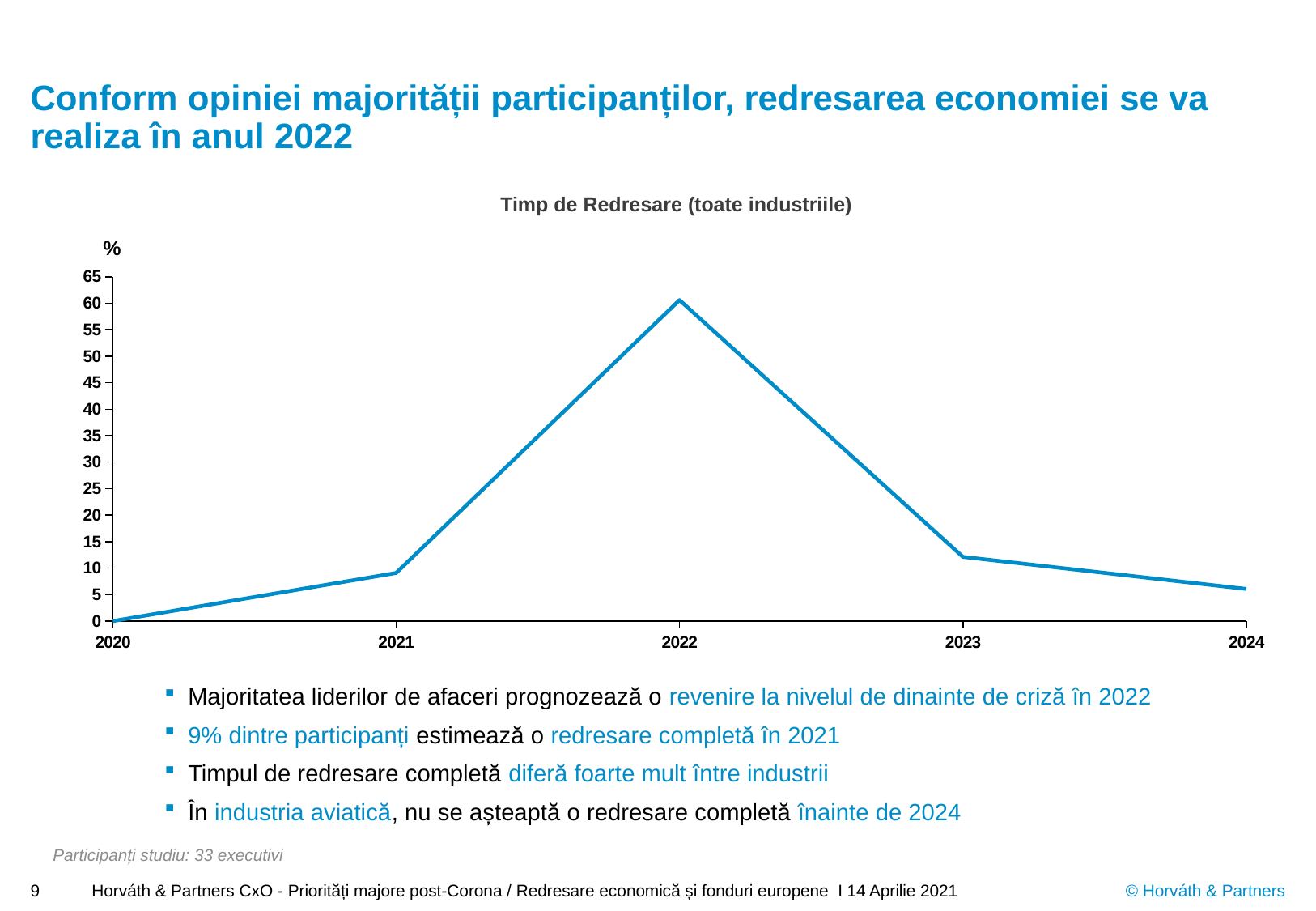
Is the value for 2023 greater or less than 20? less What kind of chart is shown on the slide? line chart Is the value for 2022 greater or less than 50? greater What unit is shown on the y axis of the chart? % Do the values rise or fall from 2022 to 2024? fall Which is larger, the value for 2022 or the value for 2023? 2022 What is the value for 2020 in the chart? 0 Which year has the highest value in the chart? 2022 What is the title of the chart? Timp de Redresare (toate industriile) How many years are plotted on the x axis of the chart? 5 Which year has the lowest value in the chart? 2020 Is the value for 2024 greater or less than 10? less